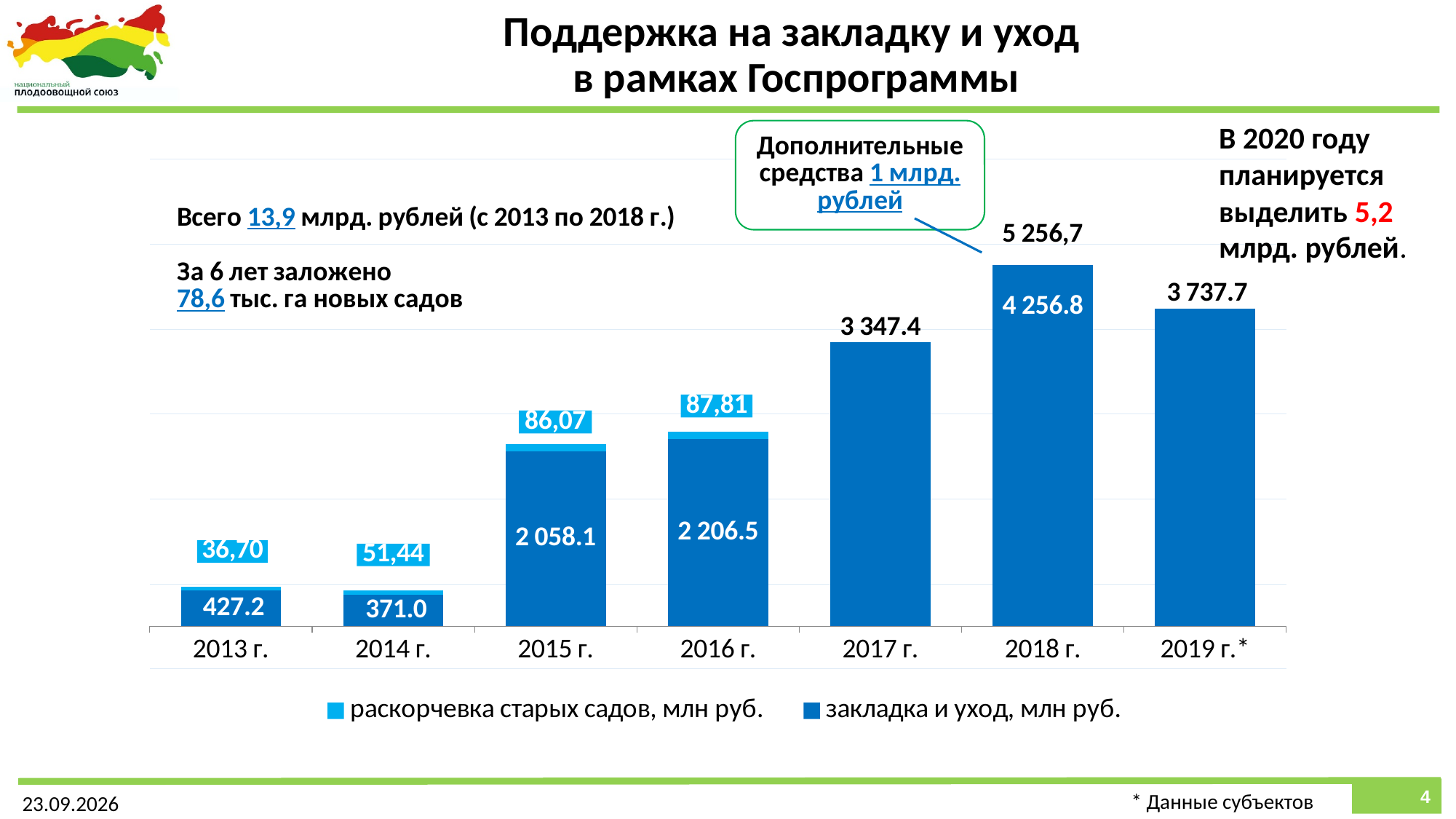
What is the value of закладка и уход, млн руб. for 2017 г.? 3 347.4 How many years are shown on the x axis of the chart? 7 What is the value of раскорчевка старых садов, млн руб. for 2013 г.? 36,70 What is the value of раскорчевка старых садов, млн руб. for 2015 г.? 86,07 What is the value of закладка и уход, млн руб. for 2014 г.? 371.0 What is the label printed above the 2018 г. bar? 5 256,7 Which is larger, the закладка и уход value for 2015 г. or for 2016 г.? 2016 г. What kind of chart is shown on the slide? stacked bar chart Which year has the lowest value of закладка и уход, млн руб.? 2014 г. Which year has the highest value of закладка и уход, млн руб.? 2018 г. How many series does the chart legend list? 2 What is the difference between the закладка и уход values for 2018 г. and 2019 г.*? 519.1